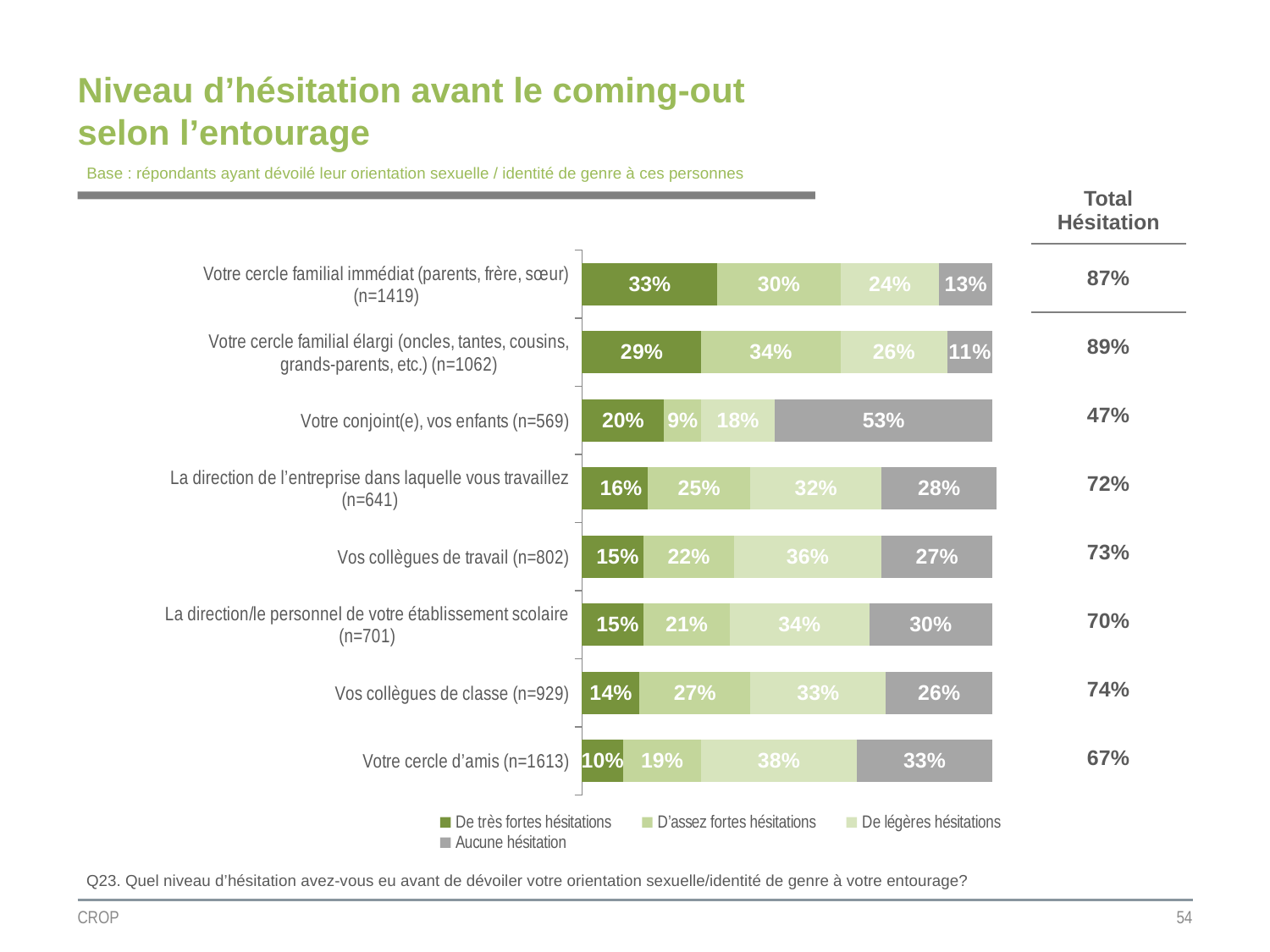
Which category has the lowest value for "Aucune hésitation"? Votre cercle familial élargi (oncles, tantes, cousins, grands-parents, etc.) Which category has the highest value for "De très fortes hésitations"? Votre cercle familial immédiat (parents, frère, sœur) Which is larger: the "Aucune hésitation" value for "Vos collègues de travail" or for "Vos collègues de classe"? Vos collègues de travail What is the "Total Hésitation" value shown for "La direction de l'entreprise dans laquelle vous travaillez"? 72% How many categories (groups of people) are shown in the chart? 8 What is the value of "Aucune hésitation" for "Votre conjoint(e), vos enfants"? 53% Which series in the legend is shown in grey? Aucune hésitation What is the difference between the "D'assez fortes hésitations" values for "Votre cercle familial élargi" and "Votre conjoint(e), vos enfants"? 25% What is the value of "De très fortes hésitations" for "Votre cercle familial immédiat (parents, frère, sœur)"? 33% What is the value of "De légères hésitations" for "Votre cercle d'amis"? 38% What type of chart is shown on the slide? Stacked bar chart How many series does the legend list? 4